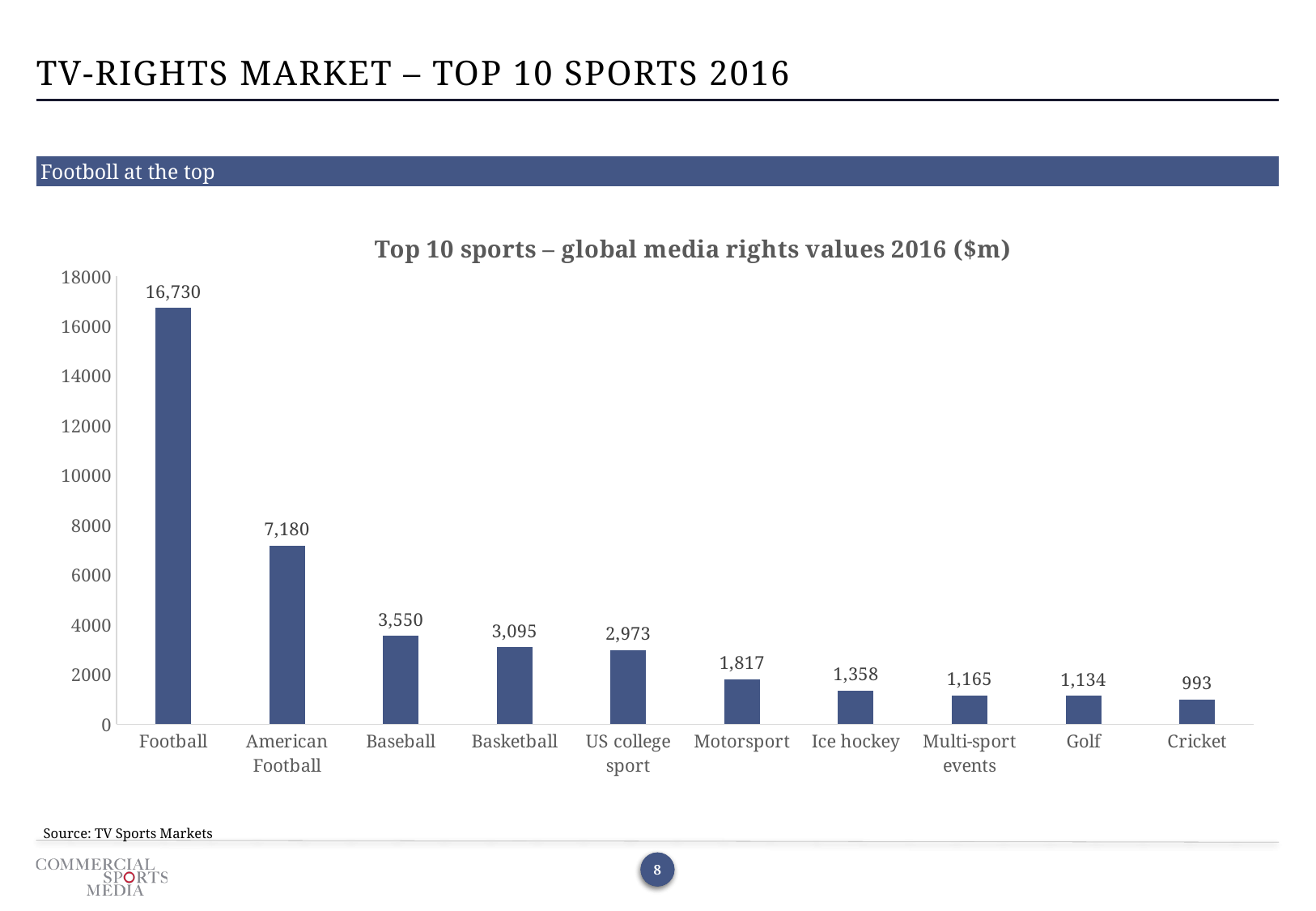
What is the title of the chart? Top 10 sports – global media rights values 2016 ($m) Which sport has the highest global media rights value? Football Which sport has the lowest global media rights value? Cricket What is the difference between the values for Baseball and Basketball? 455 What is the difference between the values for Football and American Football? 9,550 What kind of chart is shown on the slide? Bar chart What is the global media rights value for Basketball? 3,095 How many sports are shown in the chart? 10 What is the global media rights value for Golf? 1,134 What is the global media rights value for Football? 16,730 Which has a larger value, Motorsport or Ice hockey? Motorsport Is the value for US college sport greater or less than 2000? greater